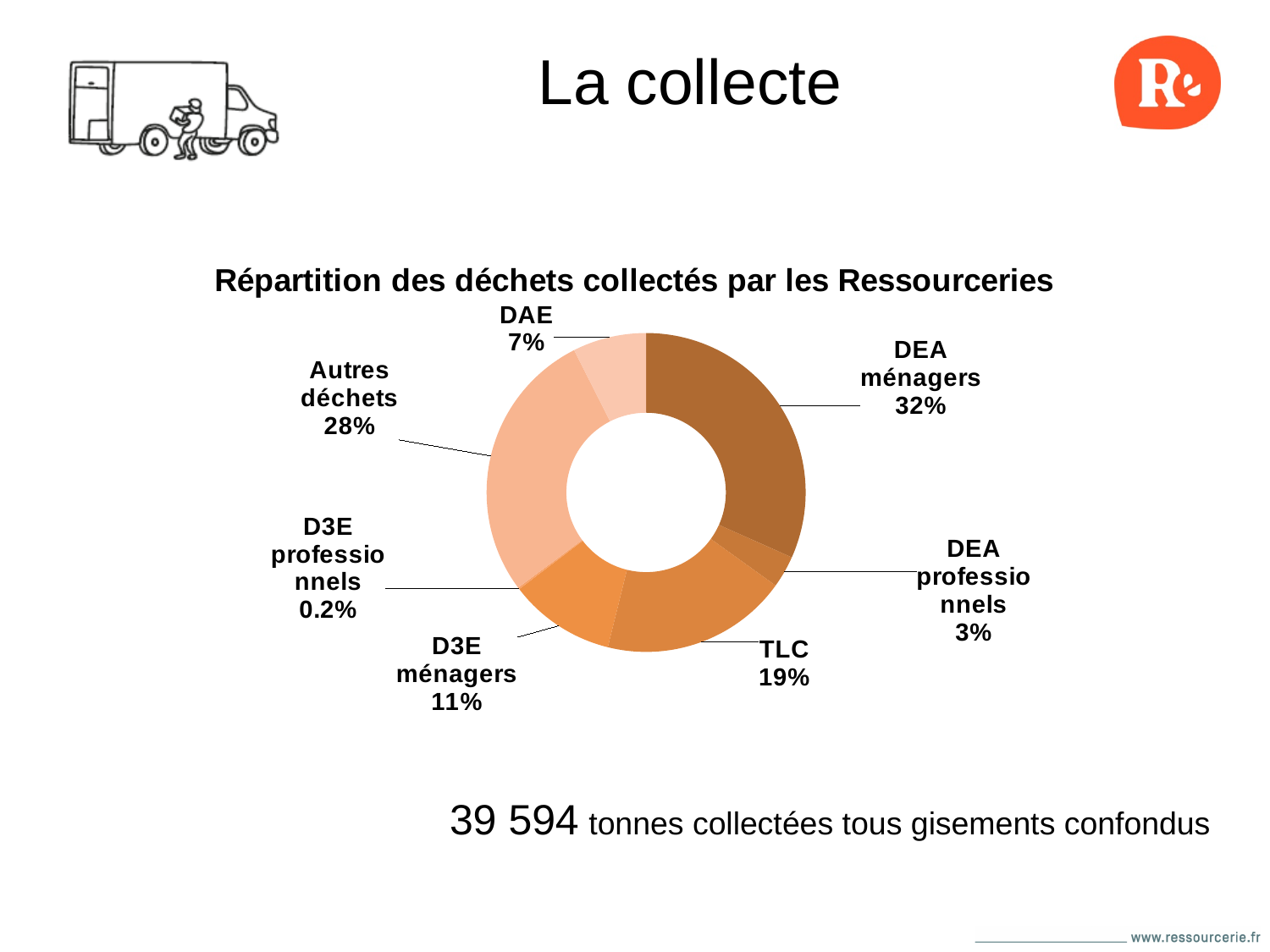
What share of the collected waste is DEA ménagers? 32% What share of the collected waste is Autres déchets? 28% What share of the collected waste is D3E professionnels? 0.2% What is the difference in percentage points between DEA ménagers and Autres déchets? 4 What share of the collected waste is DAE? 7% Which category has the smallest share of the collected waste? D3E professionnels What kind of chart is shown on the slide? Pie chart (doughnut) What share of the collected waste is TLC? 19% Which category has the largest share of the collected waste? DEA ménagers Which is larger, the share for TLC or the share for D3E ménagers? TLC How many categories are shown in the chart? 7 What is the title of the chart? Répartition des déchets collectés par les Ressourceries